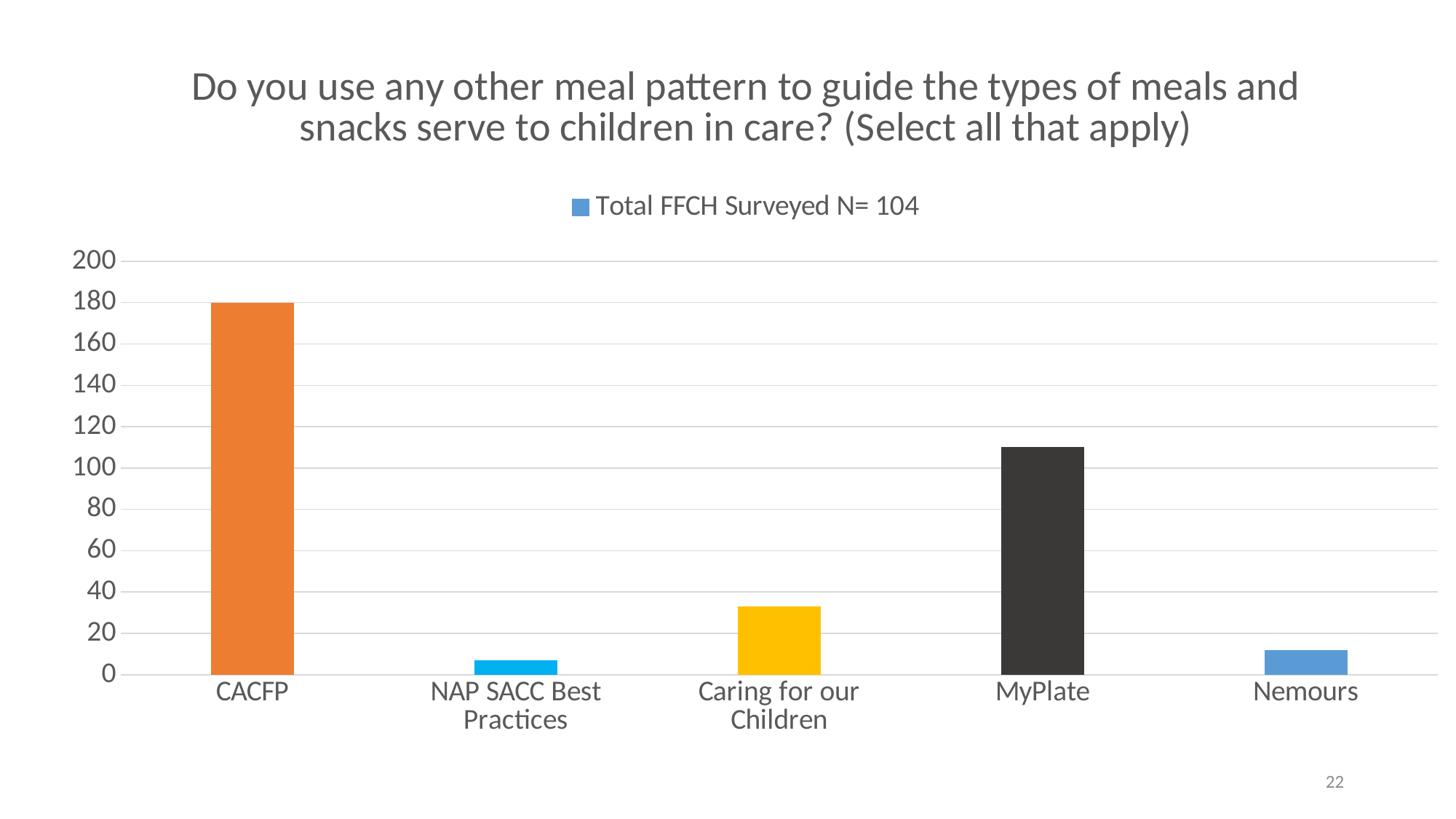
What is the value for CACFP? 180 Is the value for MyPlate greater or less than 100? greater What kind of chart is shown on the slide? Bar chart How many series does the legend list? 1 Is the value for Caring for our Children greater or less than 40? less Which category has the highest value? CACFP Is the value for Nemours greater or less than 20? less How many categories are shown on the x axis of the chart? 5 Which category has the lowest value? NAP SACC Best Practices What is the highest value shown on the y axis? 200 What is the legend entry shown above the chart? Total FFCH Surveyed N= 104 Which is larger, the value for MyPlate or the value for Caring for our Children? MyPlate